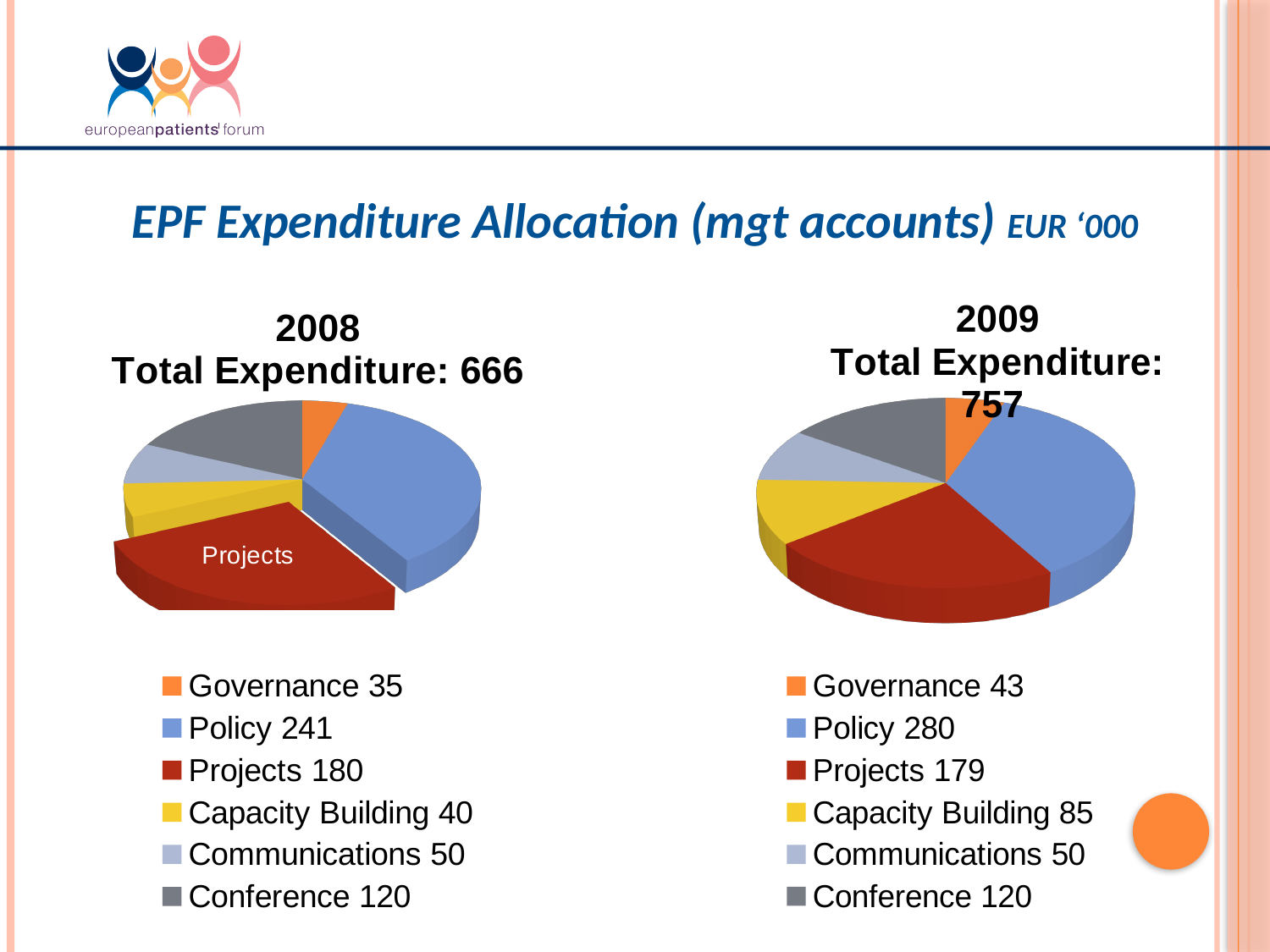
In the 2009 chart, what is the value for Capacity Building? 85 Which slice is pulled out from the 2008 pie chart? Projects In the 2009 chart, what is the difference between Policy and Projects? 101 What type of chart is used for the 2008 expenditure allocation? Pie chart In the 2008 chart, what is the value for Policy? 241 In the 2008 chart, which is larger, Conference or Communications? Conference How many categories does the 2009 chart's legend list? 6 In the 2009 chart, which category has the highest value? Policy What is the total expenditure shown in the title of the 2009 chart? 757 What is the total expenditure shown in the title of the 2008 chart? 666 In the 2008 chart, which category has the lowest value? Governance What is the difference between the 2009 and 2008 values for Governance? 8